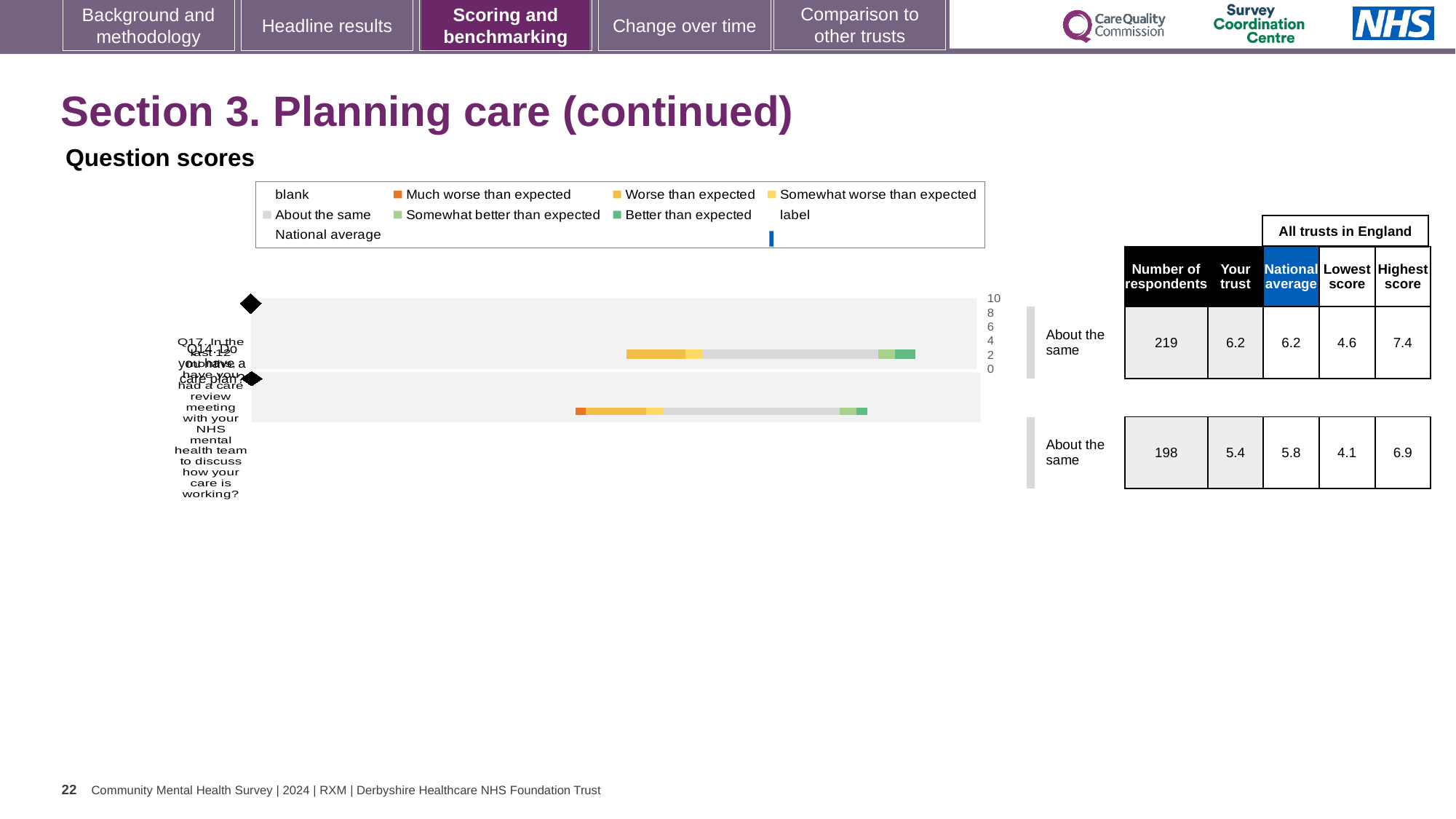
For the second (bottom) question row, Q17, how much higher is the national average than the 'Your trust' score? 0.4 What is the national average for the second (bottom) question row, Q17? 5.8 What is the lowest score among all trusts in England for the first (top) question row? 4.6 What is the highest score among all trusts in England for the second (bottom) question row, Q17? 6.9 What benchmark category is shown for the second (bottom) question row, Q17? About the same Which question row has more respondents, the top row or the bottom row (Q17)? Top row What kind of chart is used to show the question scores on this slide? bar chart For the first (top) question row, what is the difference between the highest score and the lowest score? 2.8 In the table next to the chart, how many respondents are listed for the first (top) question row? 219 How many questions (rows) are plotted in the question scores chart? 2 What is the 'Your trust' score for the first (top) question row? 6.2 For the second (bottom) question row, Q17, which is larger: the 'Your trust' score or the national average? National average